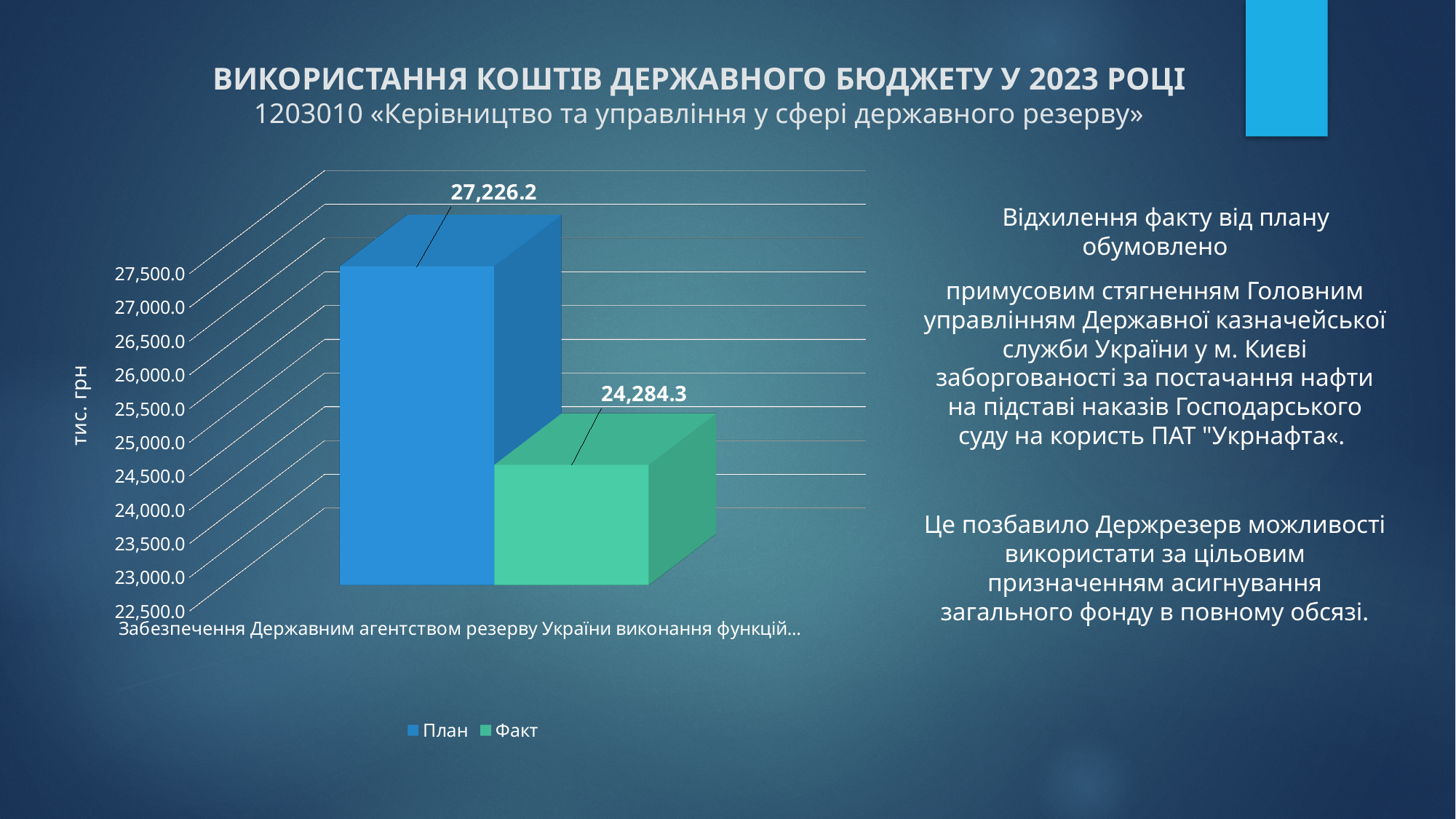
Which series has the lowest value on the chart? Факт Is the value for Факт greater or less than 25,000.0? less What kind of chart is shown on the slide? bar chart How many categories are shown on the x axis of the chart? 1 What colour is the bar for the Факт series? green Is the value for План greater or less than 27,000.0? greater How many series does the legend list? 2 Which series has the higher value, План or Факт? План What is the difference between the План value and the Факт value? 2,941.9 What is the label of the vertical axis of the chart? тис. грн What is the value of the План series on the chart? 27,226.2 What is the value of the Факт series on the chart? 24,284.3